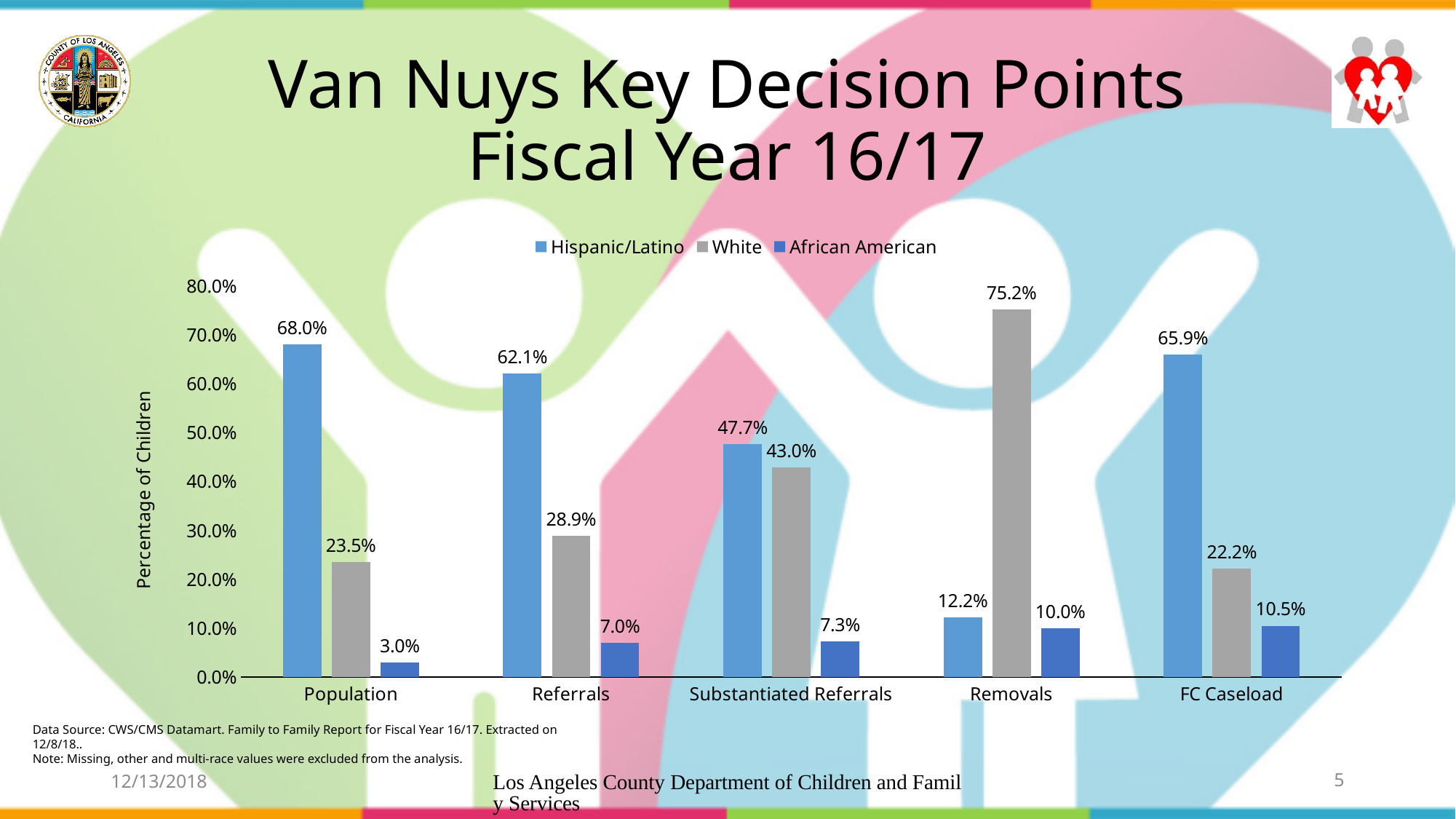
Which is larger for Removals, the Hispanic/Latino value or the White value? White How many categories are shown on the x axis? 5 Which category has the lowest Hispanic/Latino value? Removals What kind of chart is shown on the slide? Bar chart What is the African American value for FC Caseload? 10.5% What is the label of the vertical axis? Percentage of Children How many series does the legend list? 3 Which category has the highest African American value? FC Caseload What is the Hispanic/Latino value for Population? 68.0% What is the White value for Removals? 75.2% What is the White value for Substantiated Referrals? 43.0% What is the difference between the Hispanic/Latino and White values for Referrals? 33.2%